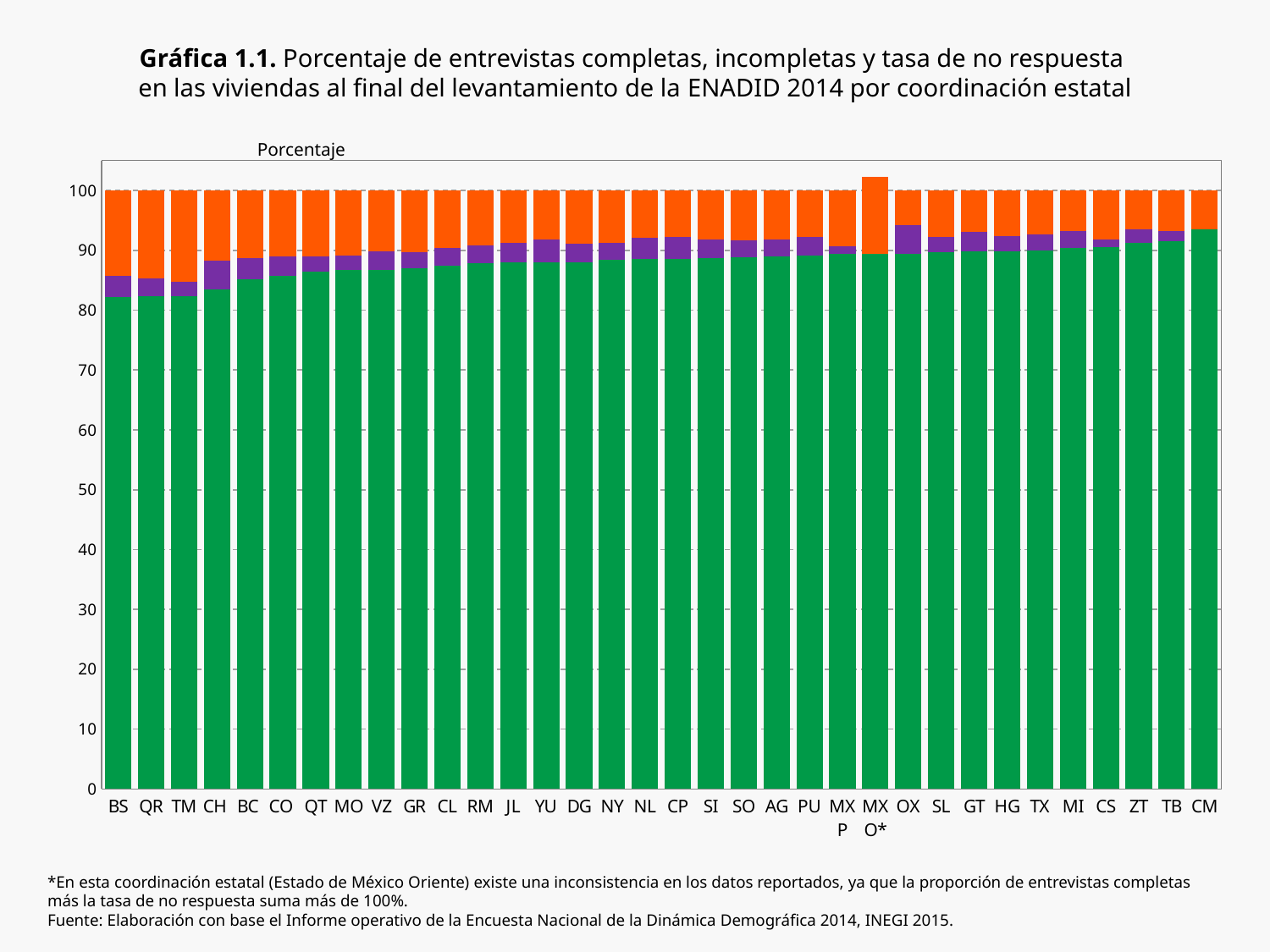
What label is shown on the vertical axis of the chart? Porcentaje Do the green segments generally rise or fall moving from left to right along the x axis? rise How many different colours are used for the segments in each stacked bar? 3 What kind of chart is shown on the slide? Stacked bar chart Which category has the tallest green segment (highest percentage of complete interviews)? CM Which has a larger green segment, BS or CM? CM Is the total height of the bar for MX O* greater or less than 100? greater Is the green segment for CM greater or less than 90? greater Is the green segment for TM greater or less than 80? greater Which category is the only one whose stacked bar rises above the 100 line? MX O* How many state coordinations (categories) are shown along the x axis? 34